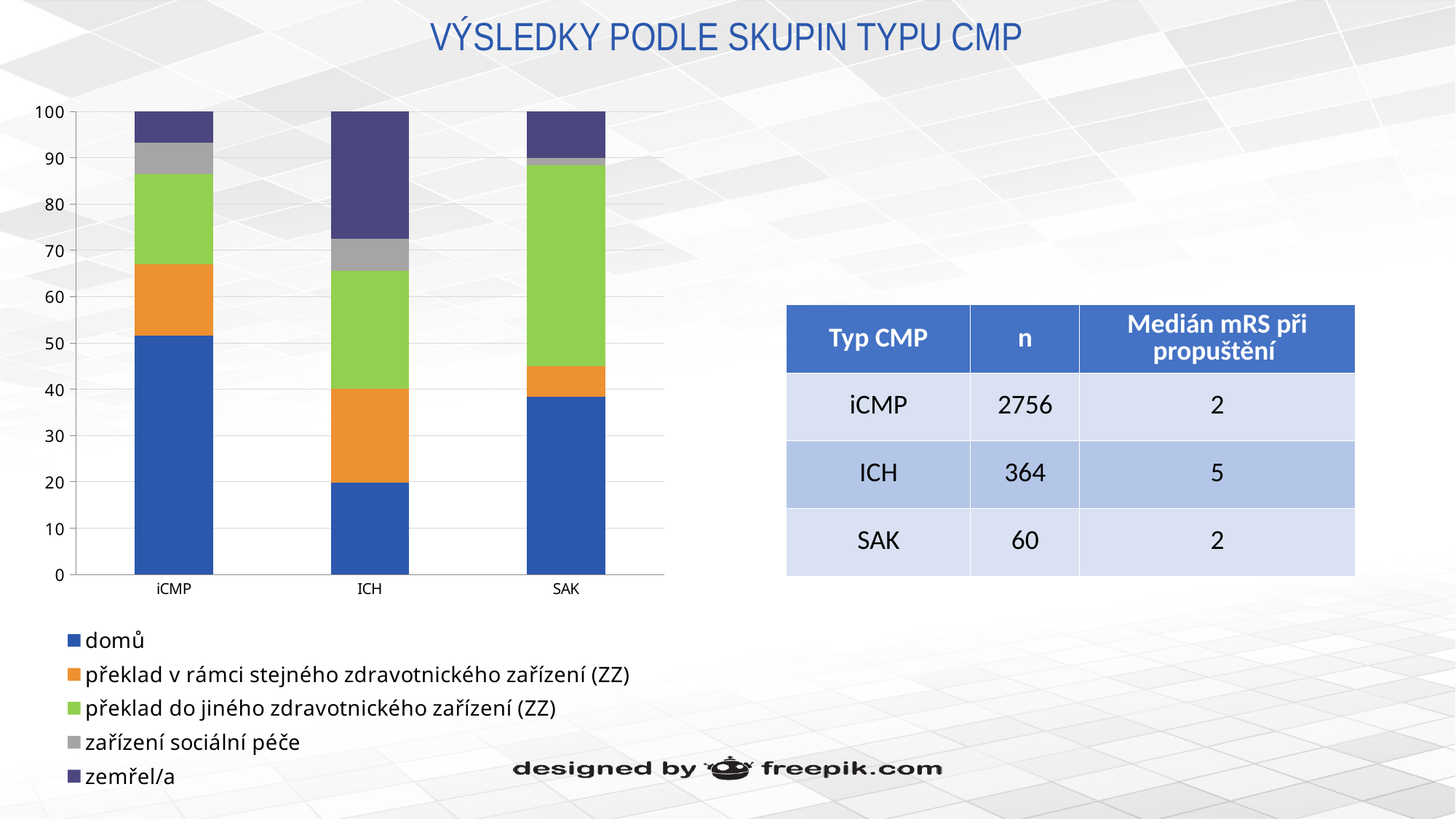
Is the value of the 'domů' segment for SAK greater or less than 30? greater What is the title of the slide containing the chart? VÝSLEDKY PODLE SKUPIN TYPU CMP Which category has the larger 'zemřel/a' segment, ICH or iCMP? ICH Is the value of the 'domů' segment for iCMP greater or less than 40? greater How many series does the chart legend list? 5 Which category has the larger 'domů' segment, iCMP or ICH? iCMP Is the value of the 'zemřel/a' segment for ICH greater or less than 20? greater How many categories (CMP types) are shown on the x axis of the chart? 3 What kind of chart is shown on the slide? stacked bar chart Which category has the larger 'překlad do jiného zdravotnického zařízení (ZZ)' segment, SAK or iCMP? SAK Which legend entry is shown in orange? překlad v rámci stejného zdravotnického zařízení (ZZ)